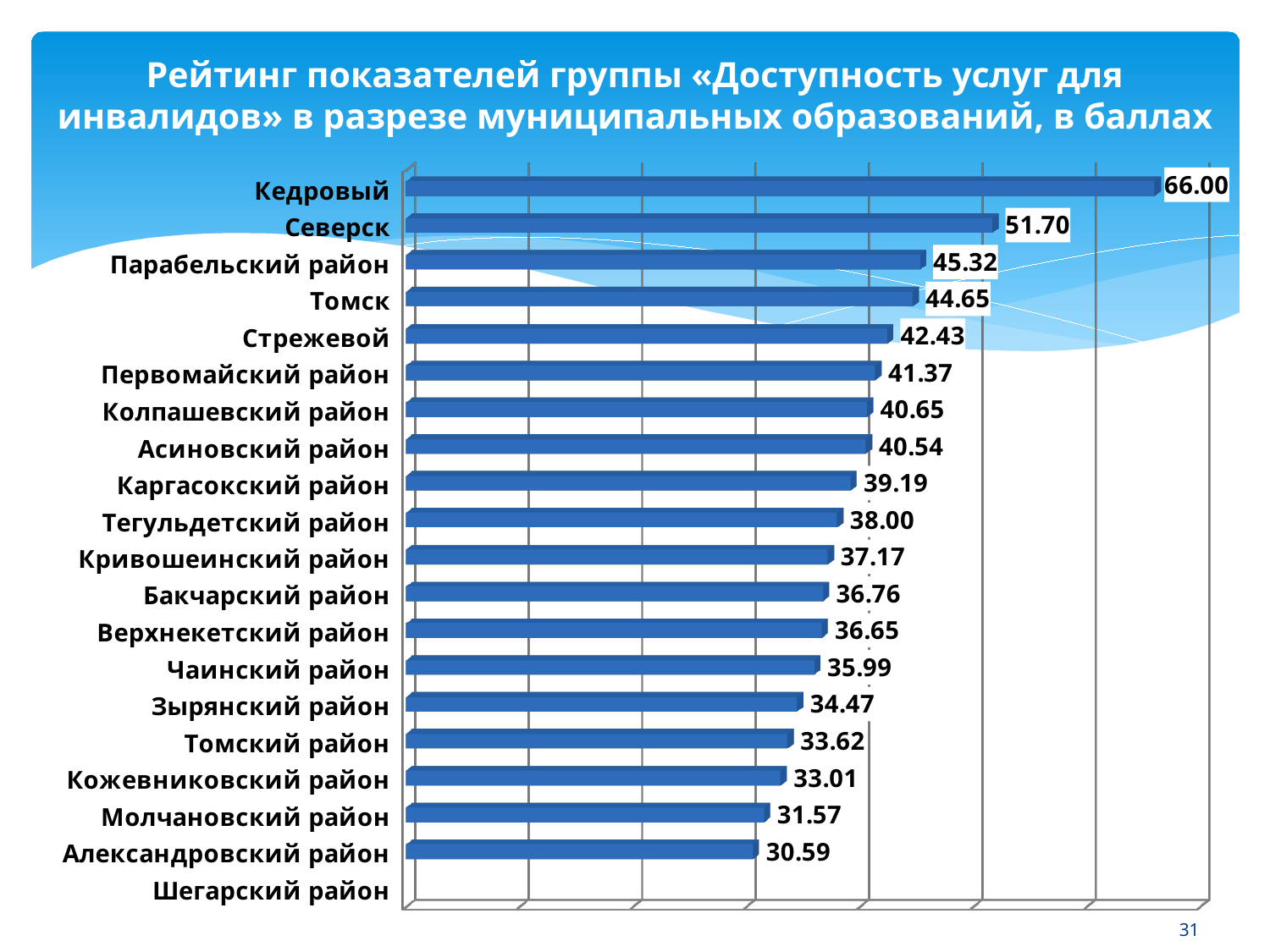
What is the value for Кедровый? 66.00 What is the value for Тегульдетский район? 38.00 Which municipality is listed without a bar or value? Шегарский район What kind of chart is shown? Bar chart Which municipality has the lowest labelled value? Александровский район Which municipality has the highest value? Кедровый How many municipalities are listed on the chart? 20 What is the difference between the values for Кедровый and Северск? 14.30 What is the difference between the values for Парабельский район and Томск? 0.67 Which has a larger value, Стрежевой or Первомайский район? Стрежевой What is the value for Томск? 44.65 What is the value for Александровский район? 30.59